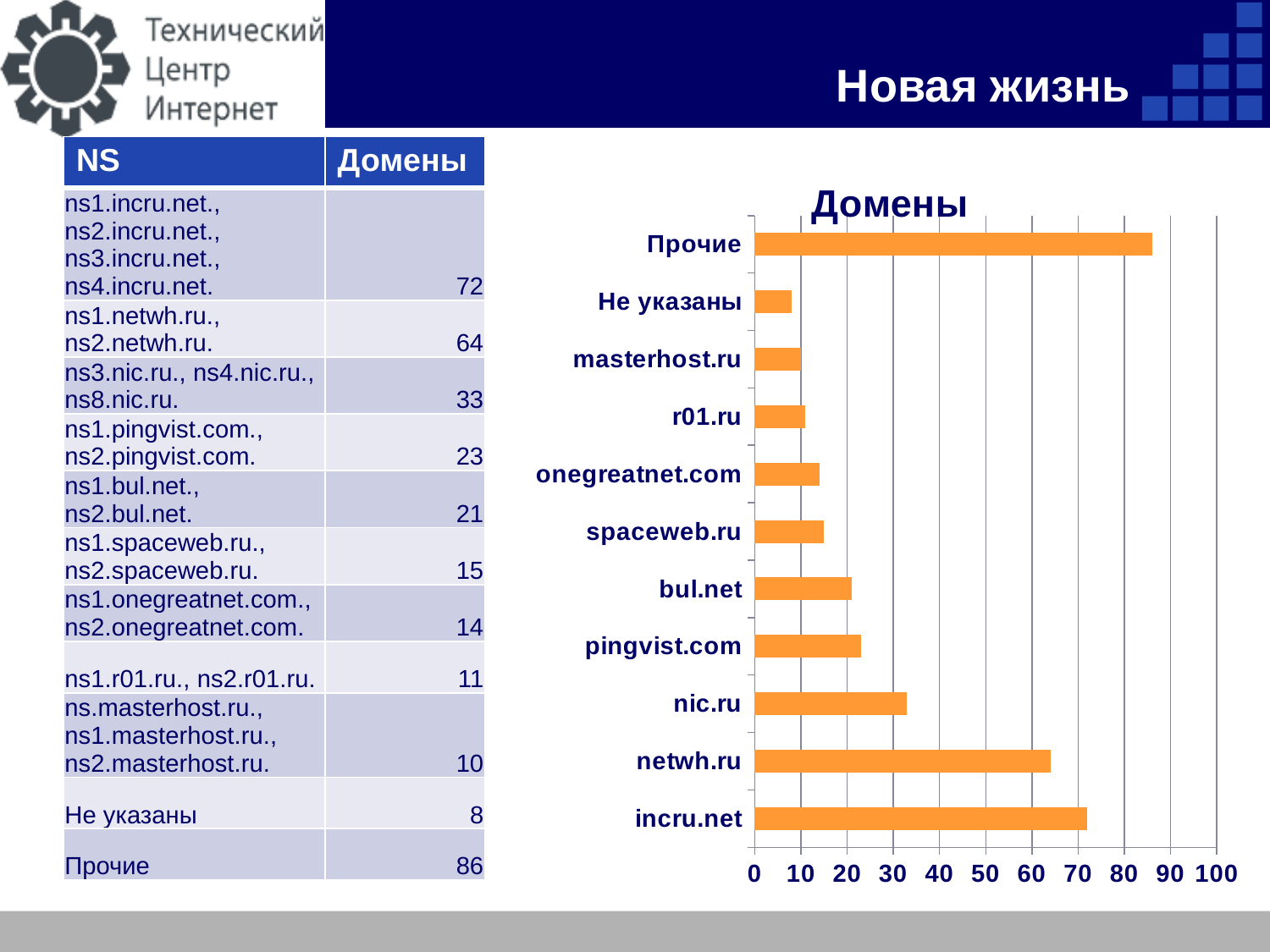
Is the value for masterhost.ru greater or less than 20? less Which category has the longest bar in the chart? Прочие How many categories (bars) does the chart show? 11 Is the value for incru.net greater or less than 70? greater Is the value for netwh.ru greater or less than 70? less What kind of chart is shown on the slide? bar chart What is the highest value shown on the horizontal axis of the chart? 100 Which is larger, the value for pingvist.com or the value for spaceweb.ru? pingvist.com Which category has the shortest bar in the chart? Не указаны What is the title of the chart? Домены Which is larger, the value for Прочие or the value for incru.net? Прочие